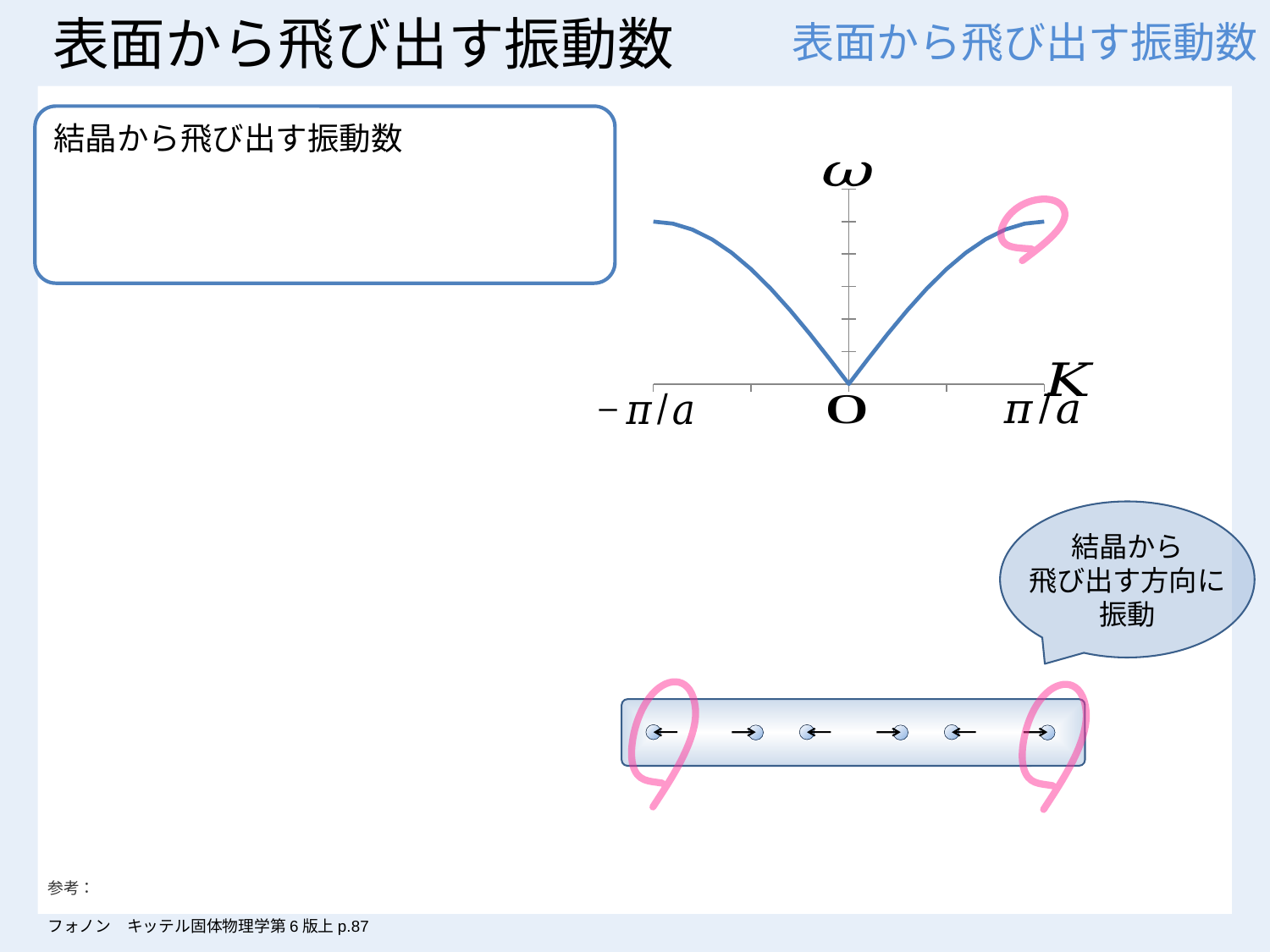
What is the label on the horizontal axis of the chart? K How many labelled tick positions are there on the horizontal axis? 3 Does the curve rise or fall as K increases from -π/a to O? fall Does the curve rise or fall as K increases from O to π/a? rise Is the value of the curve at K = π/a larger or smaller than its value at K = O? larger What kind of chart is shown on the slide? line chart At which horizontal-axis position does the curve reach its lowest value? O What is the label on the vertical axis of the chart? ω How many curves are plotted on the chart? 1